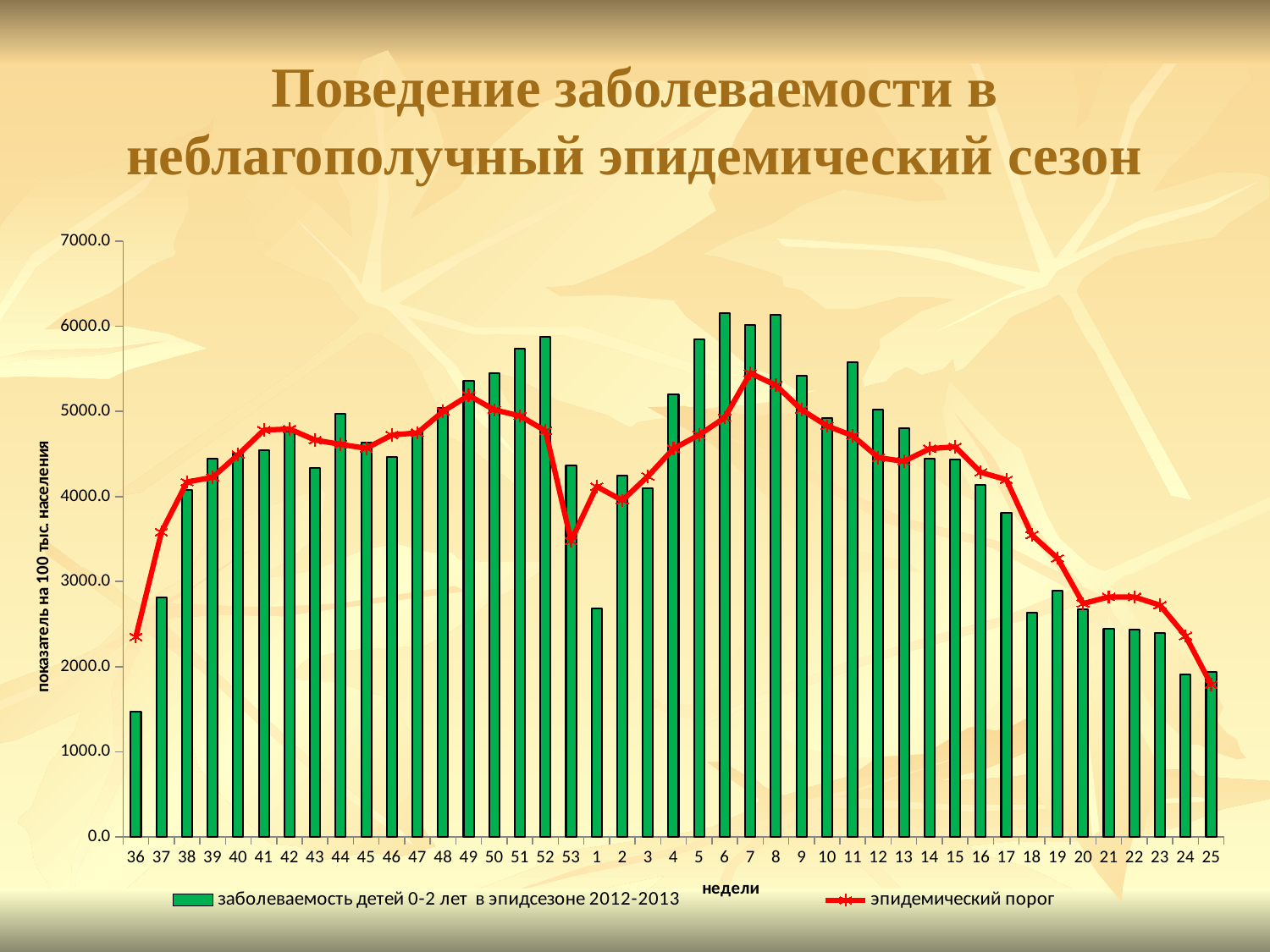
What kind of chart is shown on the slide? bar chart (with a line series) Which has the larger bar, week 17 or week 18? 17 Is the bar value for week 1 greater or less than 3000.0? less Do the bar values rise or fall from week 18 to week 25? fall How many series does the legend list? 2 How many weeks (categories) are shown on the x axis? 43 Is the bar value for week 6 greater or less than 6000.0? greater Which week has the lowest bar for заболеваемость детей 0-2 лет? 36 What is the label of the y axis? показатель на 100 тыс. населения Is the bar value for week 52 greater or less than 5000.0? greater Which has the larger bar, week 37 or week 38? 38